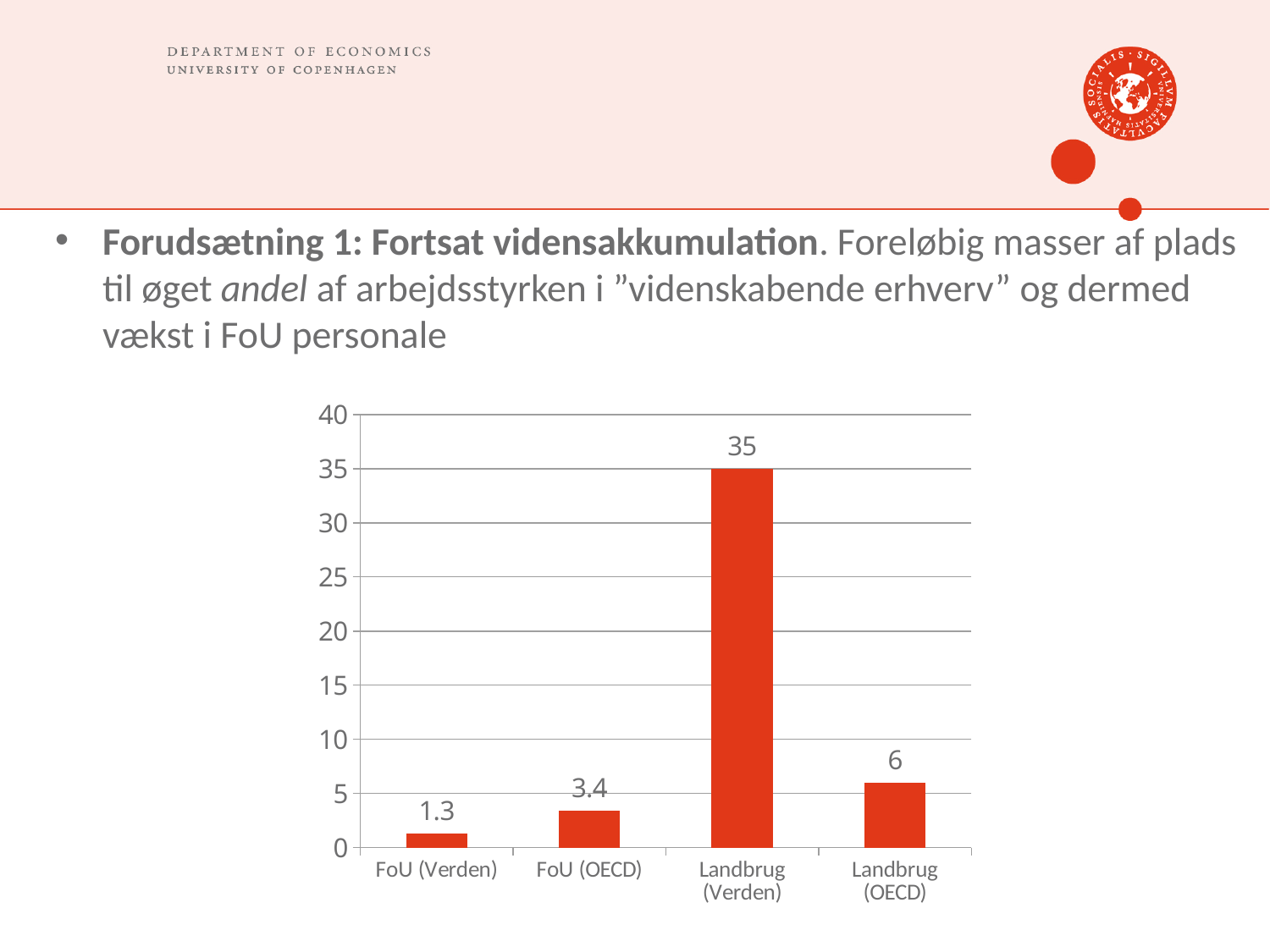
Which category has the highest value? Landbrug (Verden) What is the difference between the values for Landbrug (Verden) and Landbrug (OECD)? 29 What is the value for FoU (Verden)? 1.3 What is the difference between the values for FoU (OECD) and FoU (Verden)? 2.1 Is the value for Landbrug (Verden) greater or less than 30? greater What is the value for Landbrug (OECD)? 6 How many categories are shown on the x axis? 4 What is the value for Landbrug (Verden)? 35 What is the value for FoU (OECD)? 3.4 Which category has the lowest value? FoU (Verden) What kind of chart is shown on the slide? bar chart Which is larger, the value for FoU (OECD) or the value for Landbrug (OECD)? Landbrug (OECD)